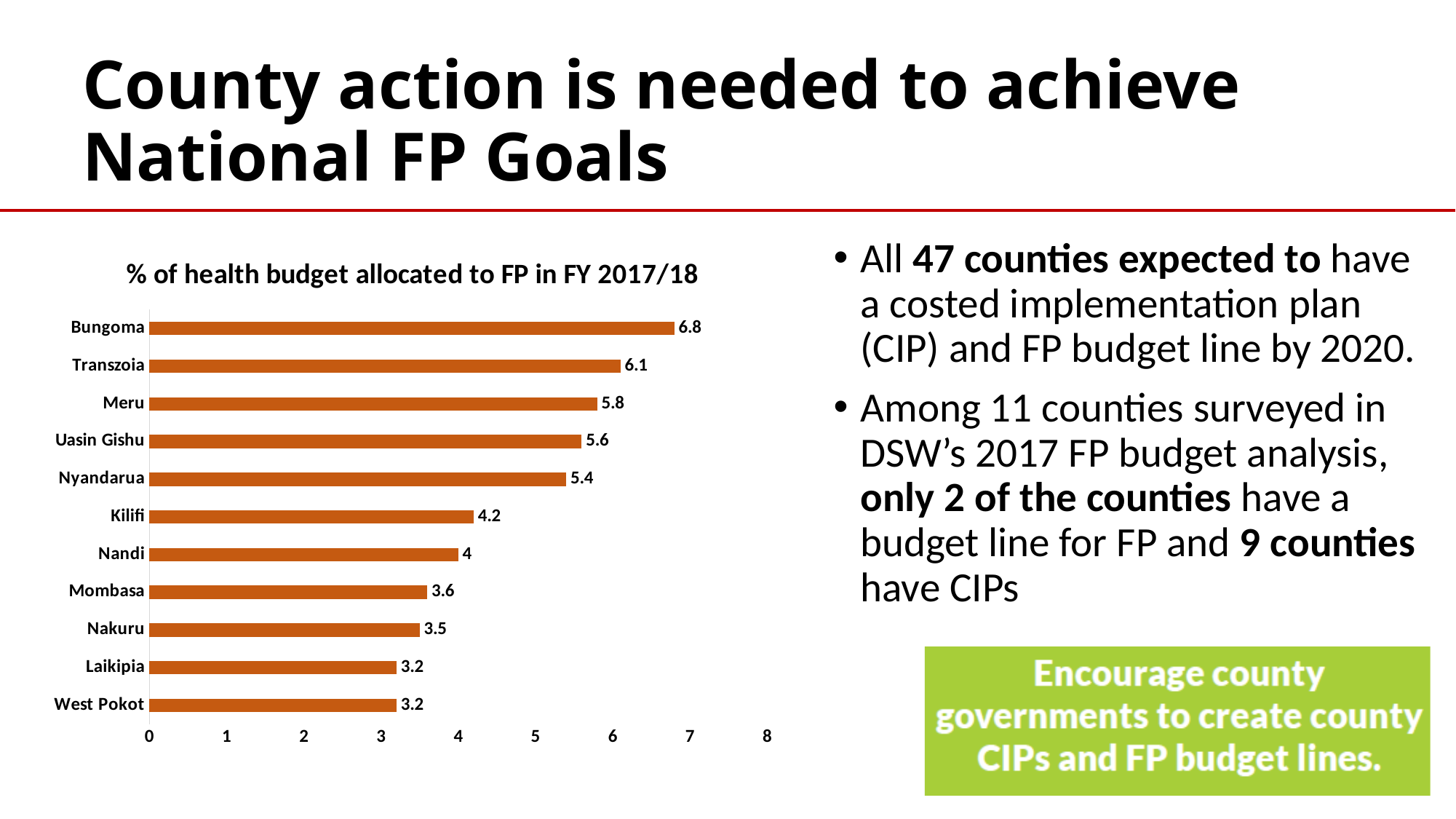
What is the difference between the values for Bungoma and Transzoia? 0.7 What is the difference between the values for Kilifi and Nandi? 0.2 What is the value for Laikipia? 3.2 Which is larger, the value for Meru or the value for Uasin Gishu? Meru Which county has the highest % of health budget allocated to FP? Bungoma What is the value for Mombasa? 3.6 Is the value for Nakuru greater or less than 4? less What is the title of the chart? % of health budget allocated to FP in FY 2017/18 What is the value for Bungoma? 6.8 What kind of chart is shown on the slide? bar chart What is the value for Nyandarua? 5.4 How many counties are shown in the chart? 11